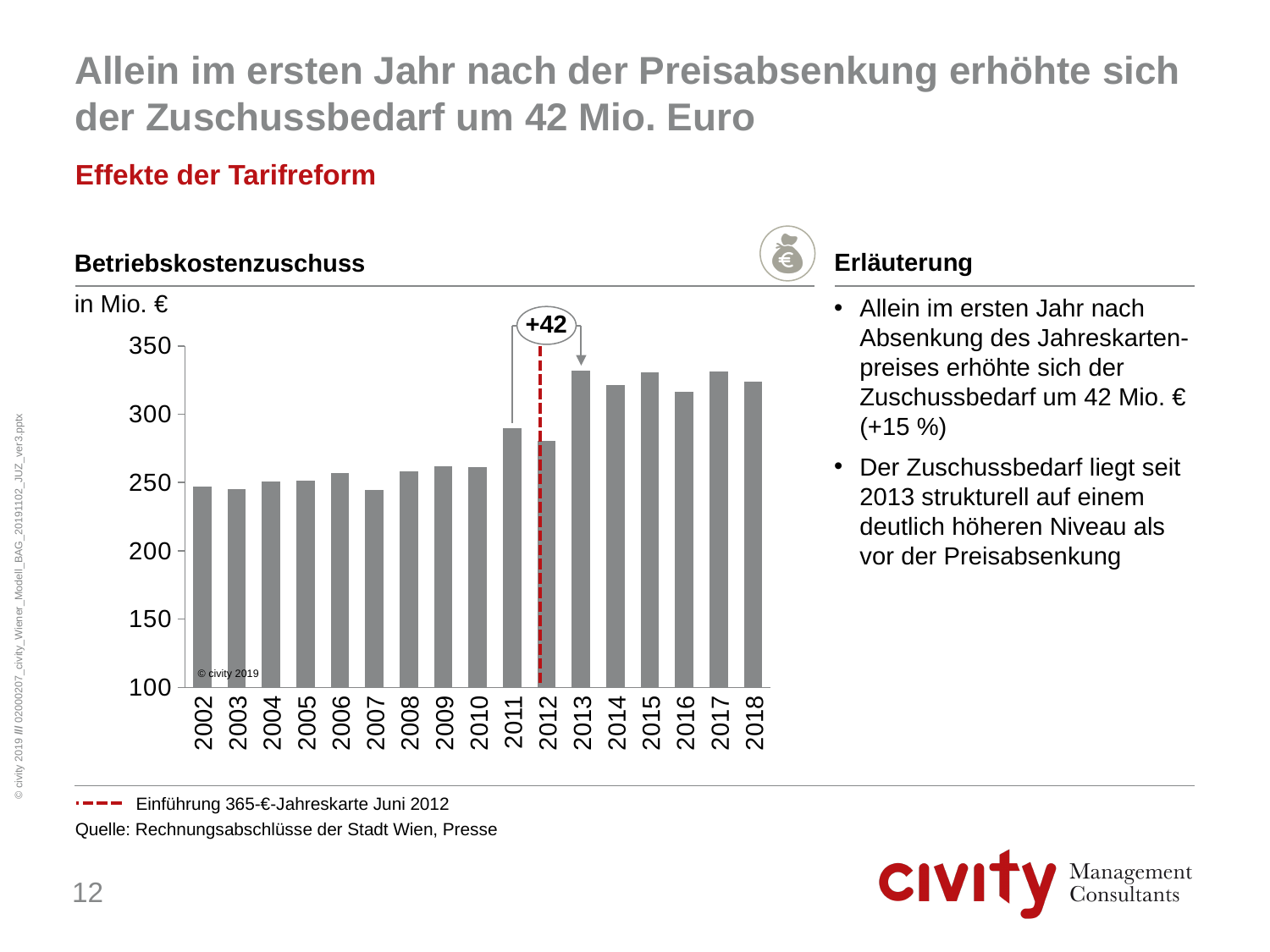
How many years are shown on the x axis of the chart? 17 Which year has the larger value, 2012 or 2013? 2013 What is the title of the chart? Betriebskostenzuschuss Is the value for 2016 greater or less than 300? greater Which year has the larger value, 2010 or 2011? 2011 Is the value for 2013 greater or less than 300? greater Is the value for 2012 greater or less than 250? greater In what unit are the values of the chart given? in Mio. € Do the values generally rise or fall from 2002 to 2018? rise What kind of chart is shown on the slide? bar chart